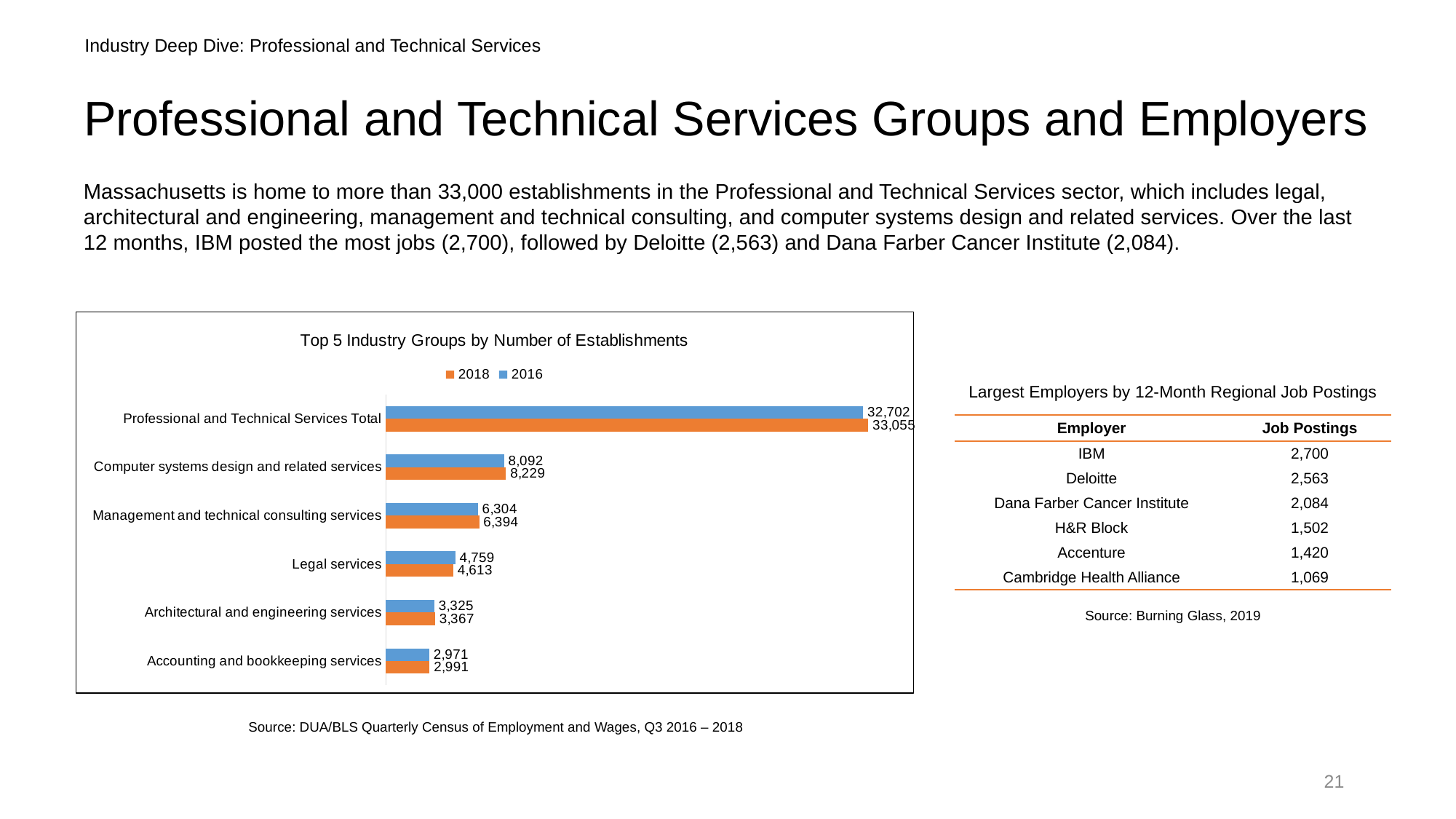
How many categories are shown on the "Top 5 Industry Groups by Number of Establishments" chart? 6 Excluding the Professional and Technical Services Total, which industry group has the highest number of establishments in 2018? Computer systems design and related services What is the 2018 value for Accounting and bookkeeping services? 2,991 What is the 2016 value for Management and technical consulting services? 6,304 What is the difference between the 2018 and 2016 values for Professional and Technical Services Total? 353 Which industry group has the lowest number of establishments in 2016? Accounting and bookkeeping services For Legal services, which year has the larger value, 2016 or 2018? 2016 What type of chart is "Top 5 Industry Groups by Number of Establishments"? Bar chart What is the 2016 value for Legal services? 4,759 Which colour represents the 2018 series in the "Top 5 Industry Groups by Number of Establishments" chart? Orange What is the 2018 value for Computer systems design and related services? 8,229 How many series does the legend of the "Top 5 Industry Groups by Number of Establishments" chart list? 2